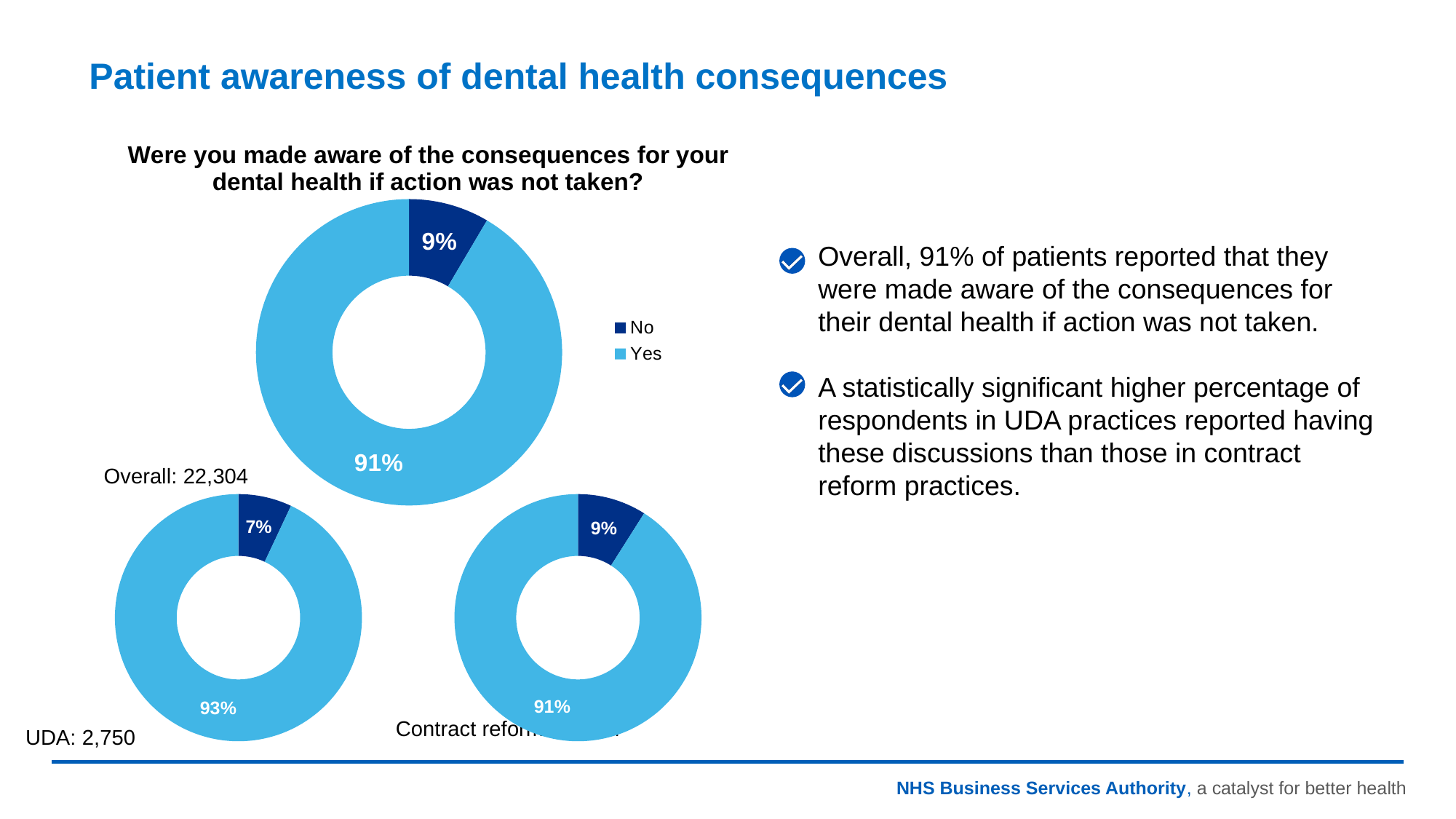
In the bottom-left doughnut chart (UDA), what percentage answered No? 7% In the large top doughnut chart (Overall), which category is the largest? Yes How many entries does the legend next to the large top chart list? 2 What is the difference between the Yes percentage in the UDA chart and the Yes percentage in the Contract reform chart? 2% In the bottom-left doughnut chart (UDA), which category is the smallest? No Which chart shows the higher Yes percentage, the bottom-left (UDA) chart or the bottom-right (Contract reform) chart? UDA In the bottom-left doughnut chart (UDA), what percentage answered Yes? 93% What type of chart is used to show the Overall responses? Doughnut chart In the bottom-right doughnut chart (Contract reform), what percentage answered Yes? 91% In the large top doughnut chart (Overall), what percentage of patients answered No? 9% In the large top doughnut chart (Overall), what percentage of patients answered Yes? 91% In the bottom-right doughnut chart (Contract reform), what percentage answered No? 9%